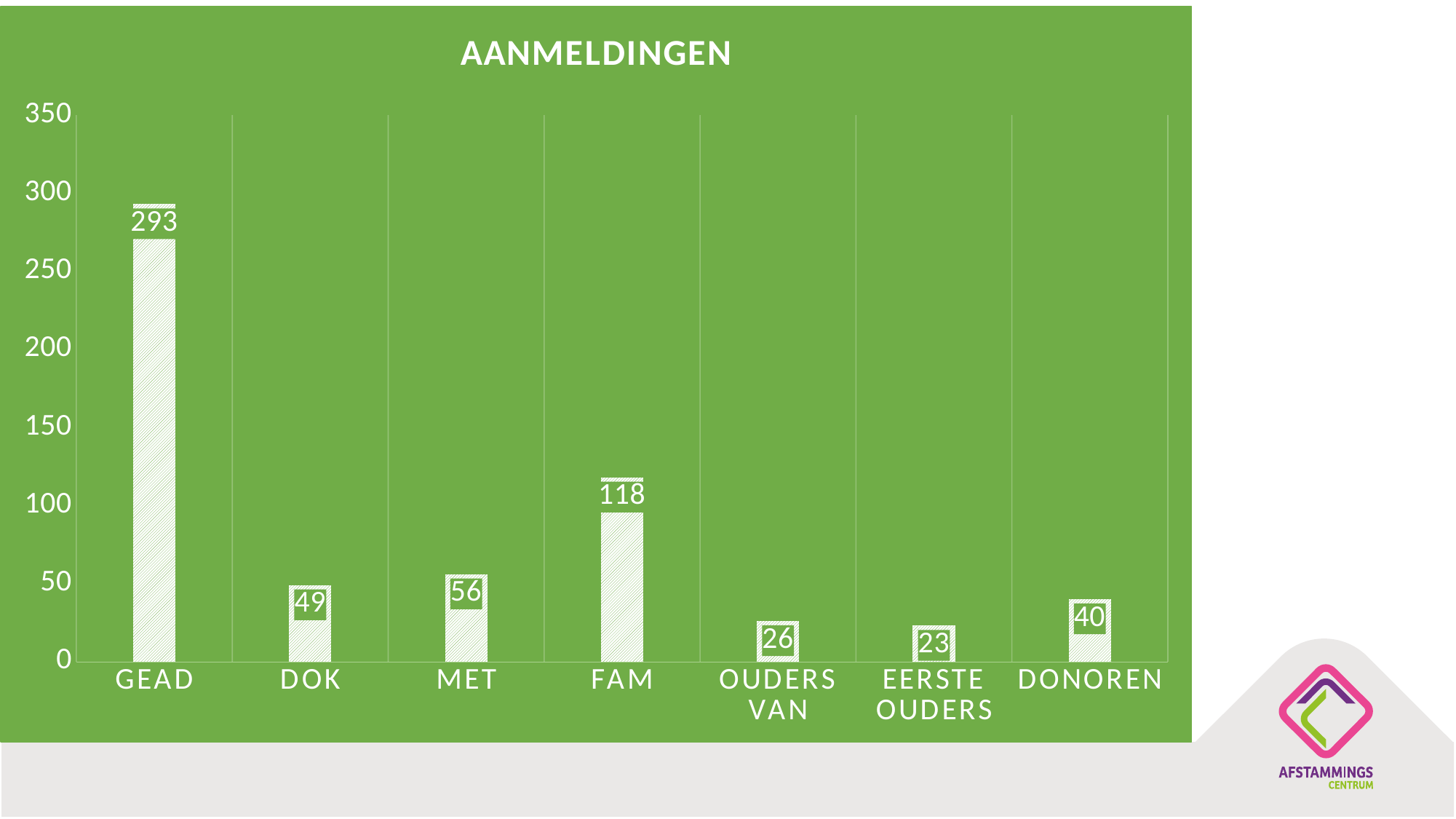
What kind of chart is shown on the slide? bar chart What is the title of the chart? AANMELDINGEN Which category has the highest value? GEAD How many categories are shown on the x axis? 7 What is the difference between the values for GEAD and FAM? 175 What is the value for FAM? 118 Which is larger, the value for DOK or the value for MET? MET Which category has the lowest value? EERSTE OUDERS What is the value for DONOREN? 40 What is the value for GEAD? 293 What is the difference between the values for MET and DOK? 7 What is the value for EERSTE OUDERS? 23